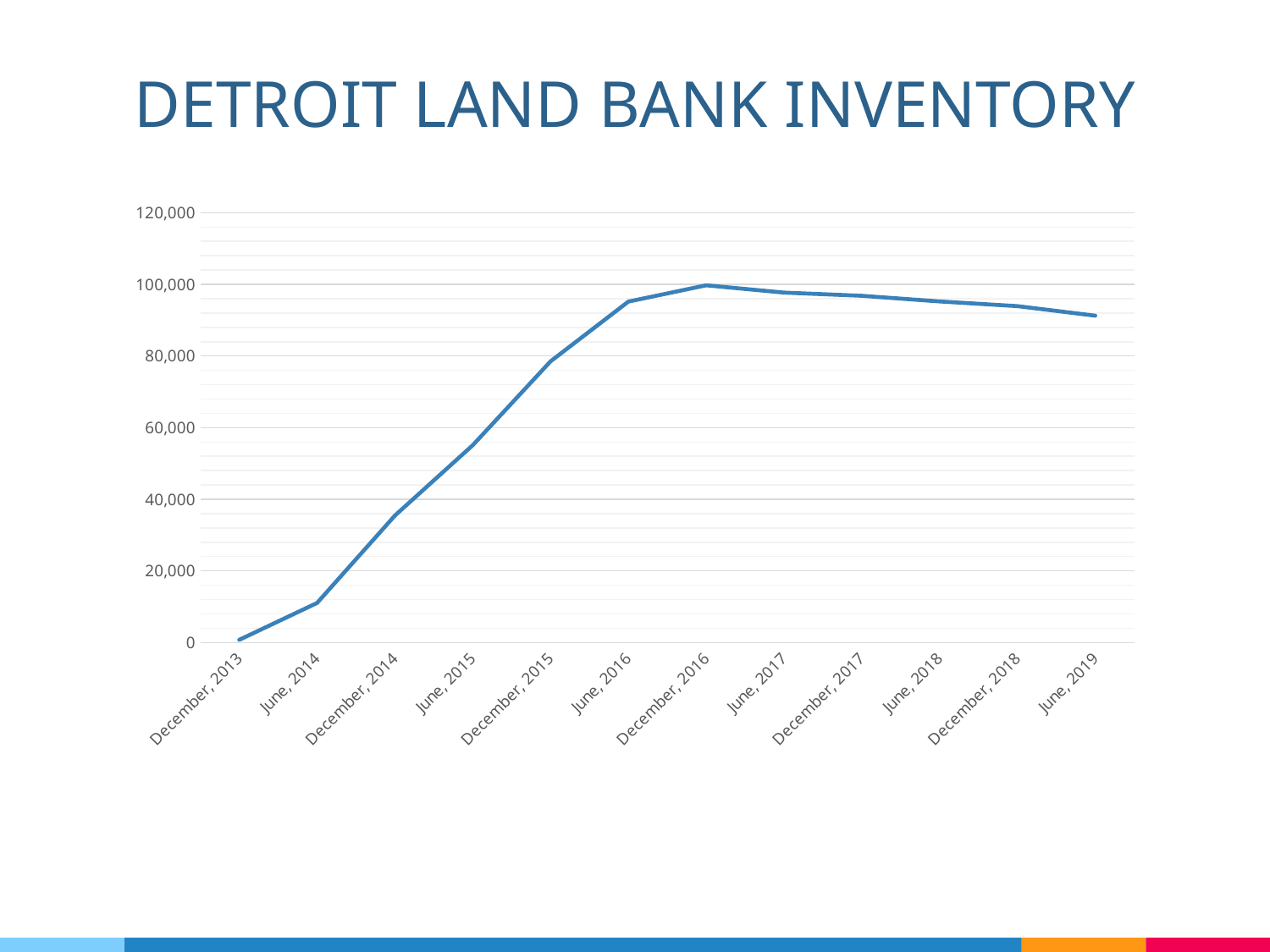
Is the value for June, 2014 greater or less than 20,000? less Which date has the lowest inventory value? December, 2013 Which date has the highest inventory value? December, 2016 Is the value for December, 2014 greater or less than 40,000? less Which is larger, the value for June, 2016 or the value for December, 2015? June, 2016 Is the value for June, 2015 greater or less than 40,000? greater What kind of chart is shown on the slide? line chart How many data points are plotted along the x axis? 12 What is the title of the chart? DETROIT LAND BANK INVENTORY Does the inventory rise or fall between December, 2013 and December, 2016? rise